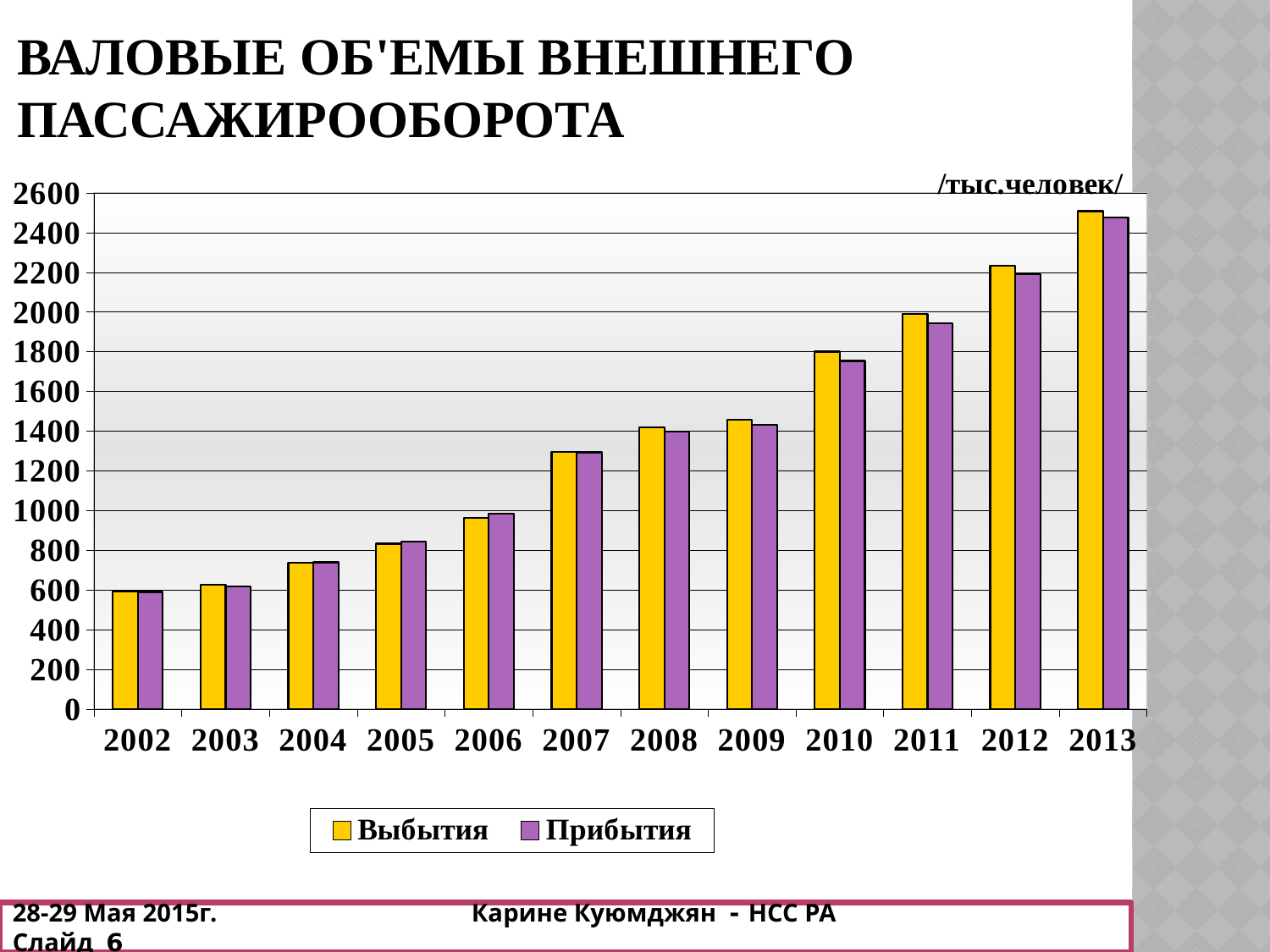
Which year has the highest value for Выбытия? 2013 Is the value for Выбытия in 2013 greater or less than 2400? greater Which year has the lowest value for Прибытия? 2002 How many series does the legend list? 2 In 2010, which is larger, Выбытия or Прибытия? Выбытия Do the values for Выбытия rise or fall from 2002 to 2013? rise What kind of chart is shown on the slide? bar chart Is the value for Выбытия in 2004 greater or less than 800? less How many years are shown on the x axis? 12 Is the value for Прибытия in 2012 greater or less than 2000? greater What unit is given above the chart? /тыс.человек/